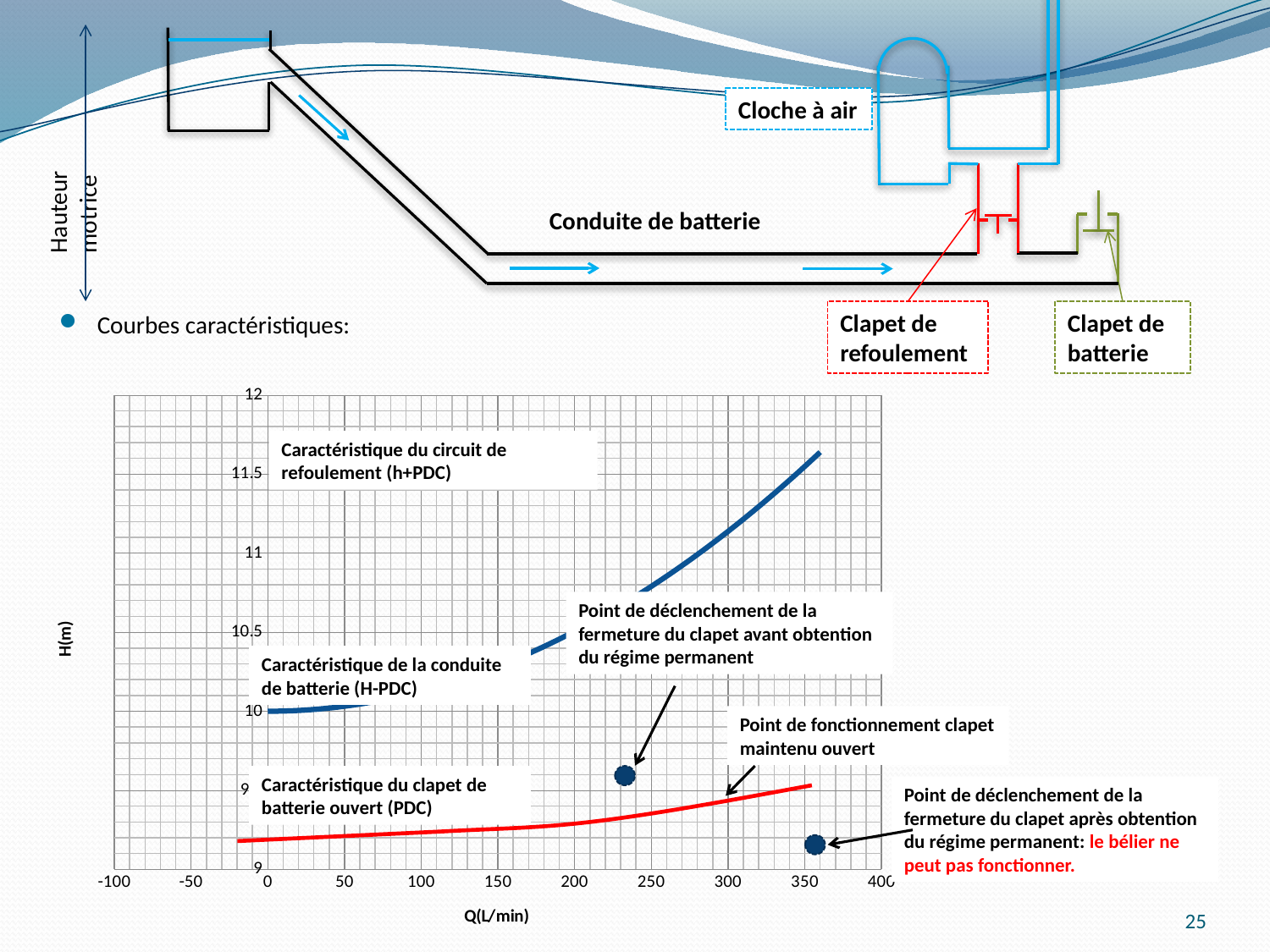
Is the value of the 'Caractéristique du circuit de refoulement (h+PDC)' curve at Q = 200 greater or less than 10? greater Does the curve 'Caractéristique du circuit de refoulement (h+PDC)' rise or fall as Q increases? rise Does the curve 'Caractéristique du clapet de batterie ouvert (PDC)' rise or fall as Q increases? rise What is the label of the y axis of the chart? H(m) What kind of chart is shown on the slide? line chart Is the value of the 'Caractéristique du circuit de refoulement (h+PDC)' curve at Q = 350 greater or less than 11? greater How many characteristic curves are labelled on the chart? 3 At Q = 300, which curve is higher: 'Caractéristique du circuit de refoulement (h+PDC)' or 'Caractéristique du clapet de batterie ouvert (PDC)'? Caractéristique du circuit de refoulement (h+PDC) What is the label of the x axis of the chart? Q(L/min) Which curve on the chart is drawn in red? Caractéristique du clapet de batterie ouvert (PDC) Is the value of the 'Caractéristique du clapet de batterie ouvert (PDC)' curve at Q = 0 greater or less than 10? less